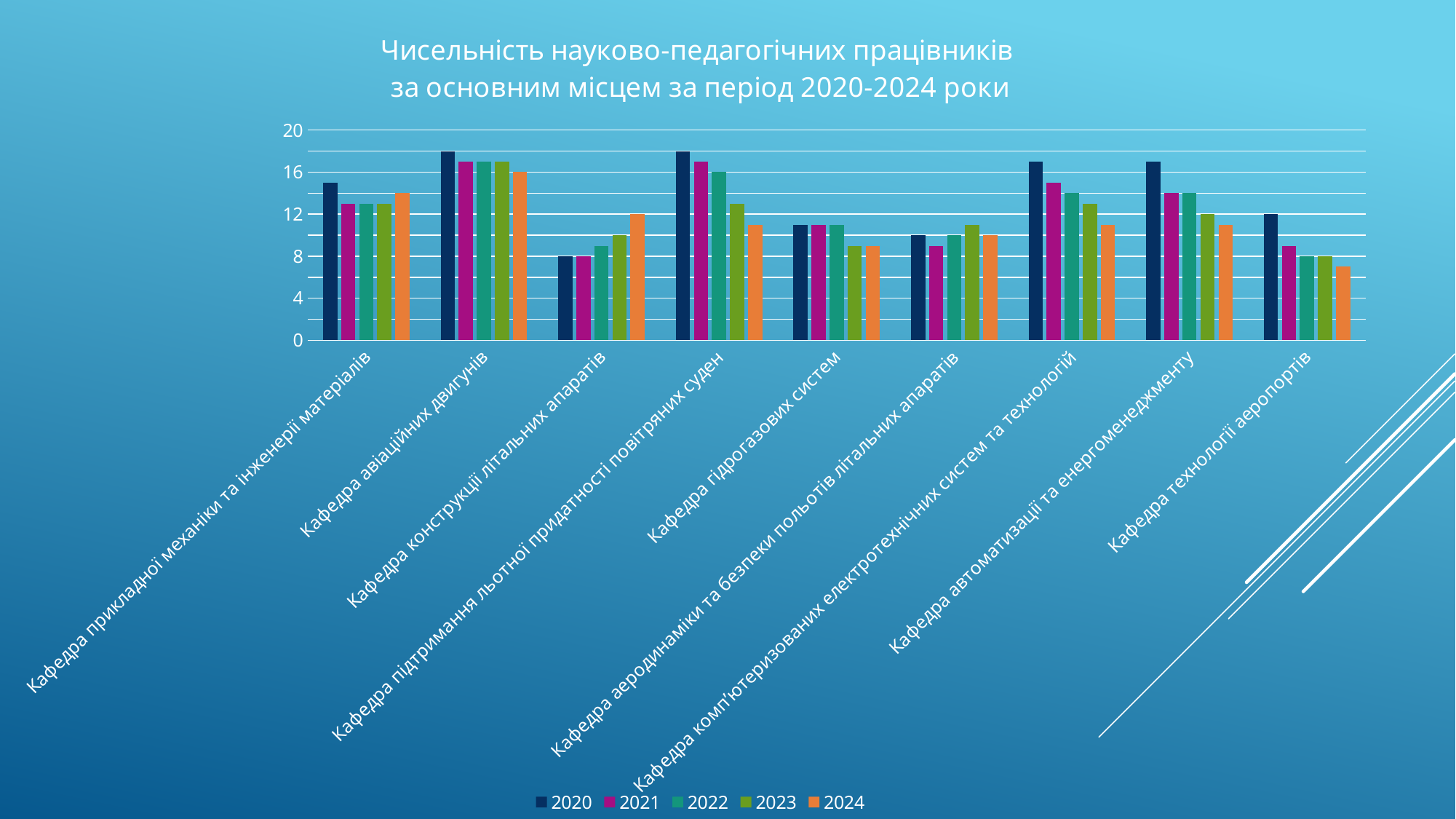
Which department has the lowest value for 2020? Кафедра конструкції літальних апаратів Which is larger: the 2020 value for Кафедра авіаційних двигунів or the 2020 value for Кафедра гідрогазових систем? Кафедра авіаційних двигунів How many departments (categories) are shown on the x axis? 9 What is the value for Кафедра конструкції літальних апаратів in 2020? 8 What is the value for Кафедра авіаційних двигунів in 2024? 16 Do the values for Кафедра технології аеропортів rise or fall from 2020 to 2024? fall Which department has the lowest value for 2024? Кафедра технології аеропортів Is the 2021 value for Кафедра аеродинаміки та безпеки польотів літальних апаратів greater or less than 12? less How many series does the legend list? 5 What type of chart is shown on the slide? bar chart Is the 2020 value for Кафедра авіаційних двигунів greater or less than 16? greater What is the value for Кафедра технології аеропортів in 2020? 12